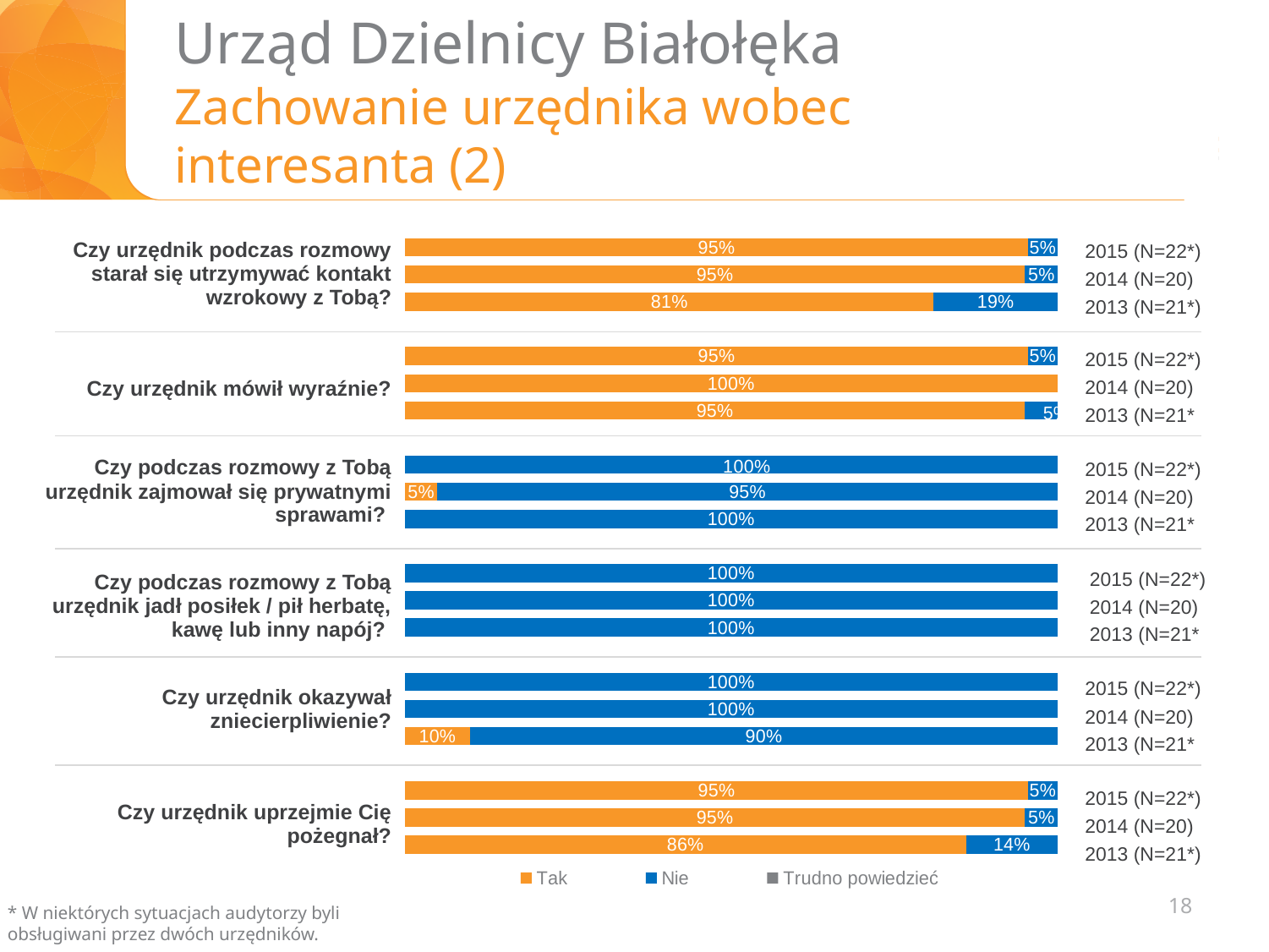
What is the 'Tak' value for 2013 for the question 'Czy urzędnik podczas rozmowy starał się utrzymywać kontakt wzrokowy z Tobą?' 81% How many survey questions (category groups) are shown in the chart? 6 What kind of chart is shown on the slide? bar chart How many series does the legend list? 3 For the question 'Czy urzędnik podczas rozmowy starał się utrzymywać kontakt wzrokowy z Tobą?', by how many percentage points is the 'Tak' value for 2015 higher than for 2013? 14 percentage points What is the 'Tak' value for 2013 for the question 'Czy urzędnik uprzejmie Cię pożegnał?' 86% What is the 'Tak' value for 2014 for the question 'Czy urzędnik mówił wyraźnie?' 100% Which colour represents the 'Tak' series in the chart? orange What is the 'Tak' value for 2013 for the question 'Czy urzędnik okazywał zniecierpliwienie?' 10% What is the 'Nie' value for 2013 for the question 'Czy urzędnik podczas rozmowy starał się utrzymywać kontakt wzrokowy z Tobą?' 19% What is the 'Tak' value for 2014 for the question 'Czy podczas rozmowy z Tobą urzędnik zajmował się prywatnymi sprawami?' 5% What is the 'Nie' value for 2013 for the question 'Czy urzędnik okazywał zniecierpliwienie?' 90%